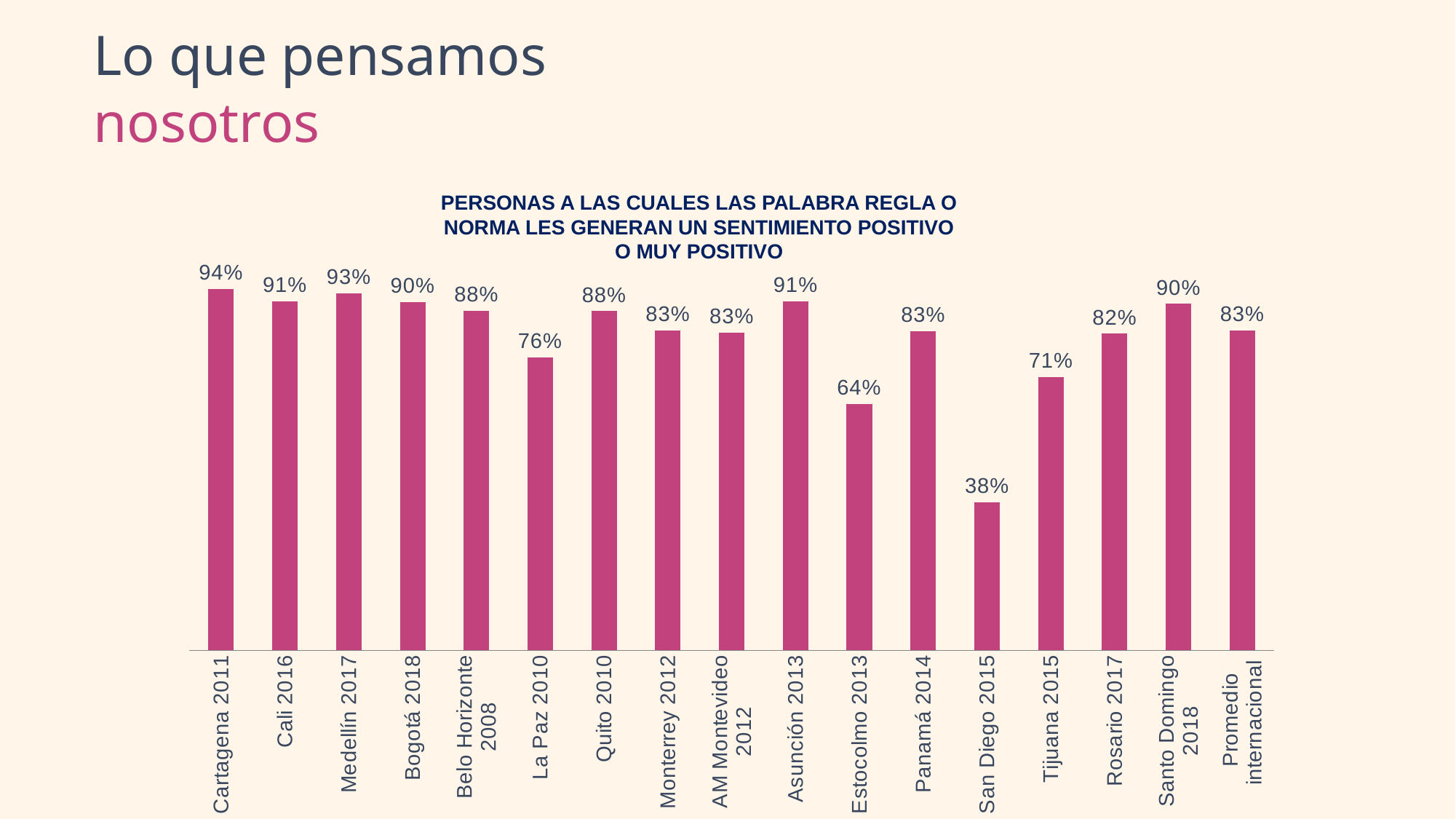
Which category has the highest value? Cartagena 2011 How many categories are shown on the x axis? 17 What is the value for Estocolmo 2013? 64% What kind of chart is shown on the slide? Bar chart What is the value for Promedio internacional? 83% What is the difference between the values for Cartagena 2011 and San Diego 2015? 56% Which category has the lowest value? San Diego 2015 What is the value for Cartagena 2011? 94% What is the value for Tijuana 2015? 71% What colour are the bars in the chart? Magenta (pink) Which is larger, the value for Medellín 2017 or the value for Bogotá 2018? Medellín 2017 What is the difference between the values for La Paz 2010 and Quito 2010? 12%